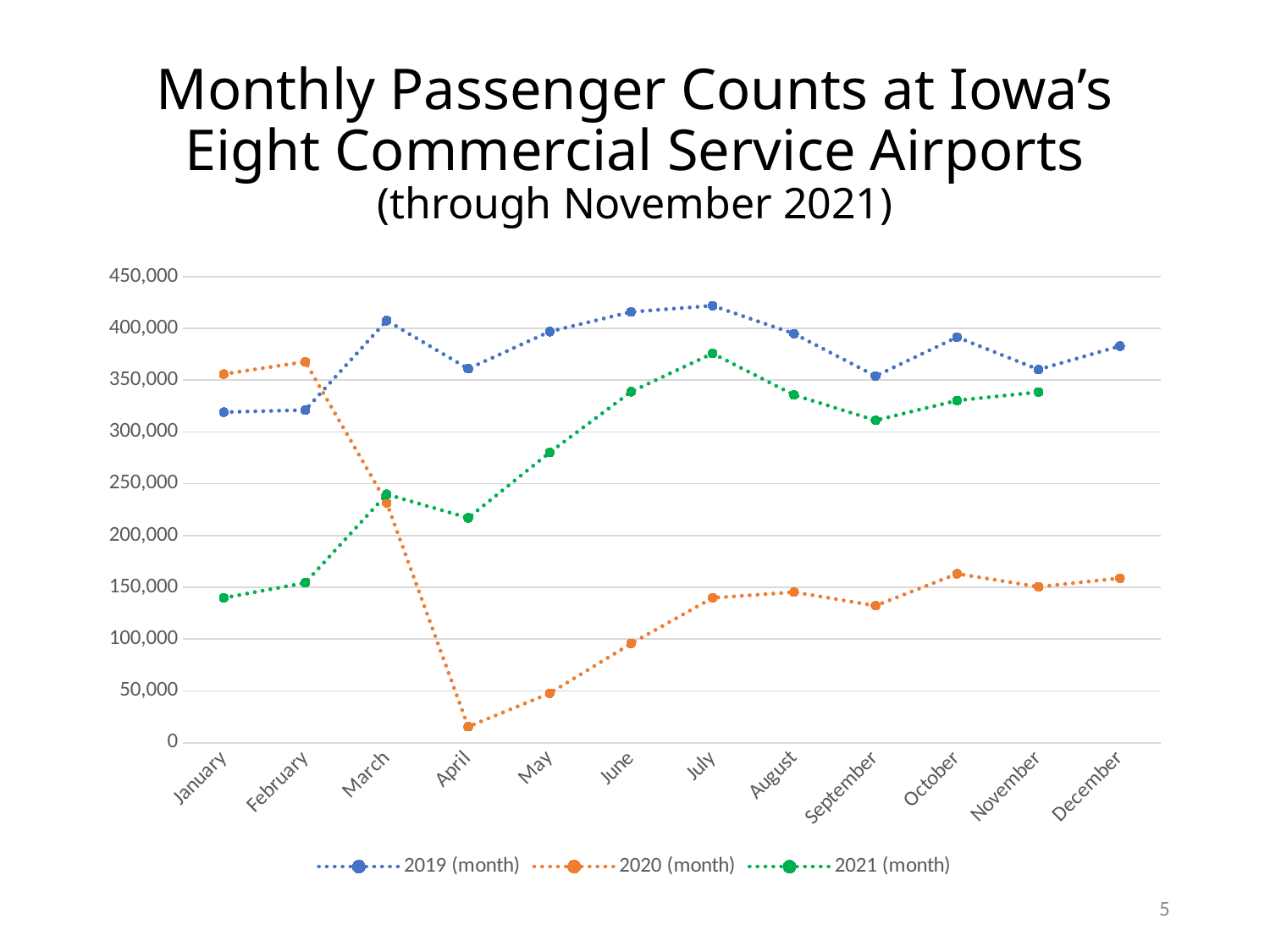
Is the value for 2019 (month) in March greater or less than 400,000? greater In which month is the 2020 (month) series at its lowest? April How many months are shown along the x axis? 12 Is the value for 2021 (month) in July greater or less than 350,000? greater In which month is the 2021 (month) series at its lowest? January How many data points does the 2021 (month) series have? 11 In June, which series has the larger value, 2019 (month) or 2021 (month)? 2019 (month) How many series does the legend list? 3 In which month is the 2021 (month) series at its highest? July What kind of chart is shown on the slide? Line chart In January, which series has the larger value, 2019 (month) or 2020 (month)? 2020 (month) Is the value for 2020 (month) in April greater or less than 50,000? less